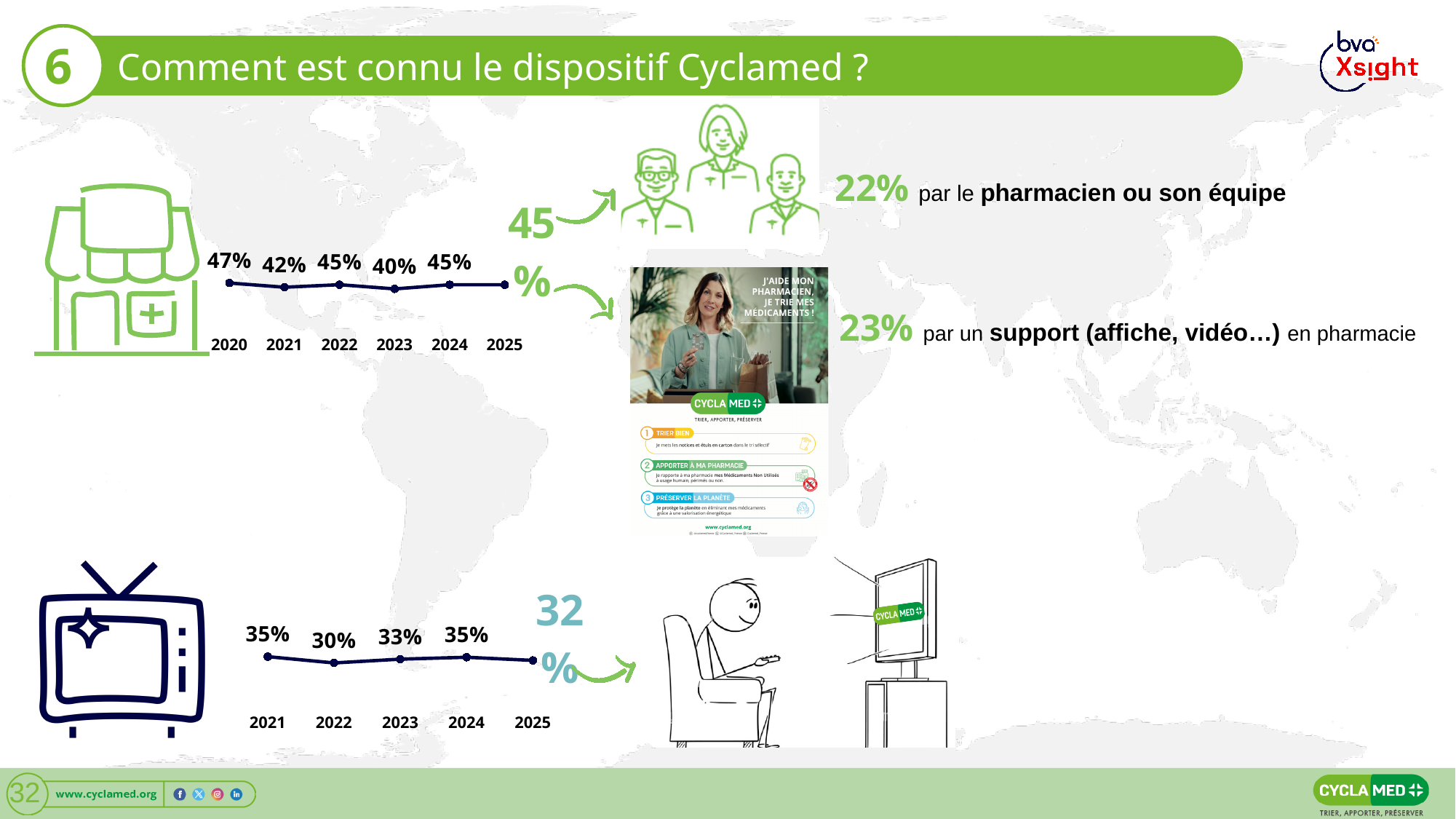
What kind of chart is used for the television data at the bottom of the slide? line chart In the bottom line chart (television), what is the value for 2025? 32% In the top line chart (pharmacy), what is the value for 2020? 47% In the top line chart (pharmacy), what is the difference between the 2020 value and the 2023 value? 7 percentage points In the top line chart (pharmacy), which year has the lowest value? 2023 In the top line chart (pharmacy), what is the value for 2025? 45% In the bottom line chart (television), what is the value for 2022? 30% In the bottom line chart (television), is the value for 2023 larger or smaller than the value for 2024? smaller In the top line chart (pharmacy), what is the value for 2023? 40% In the bottom line chart (television), which year has the lowest value? 2022 In the top line chart (pharmacy), which year has the highest value? 2020 In the top line chart (pharmacy), how many years are plotted? 6